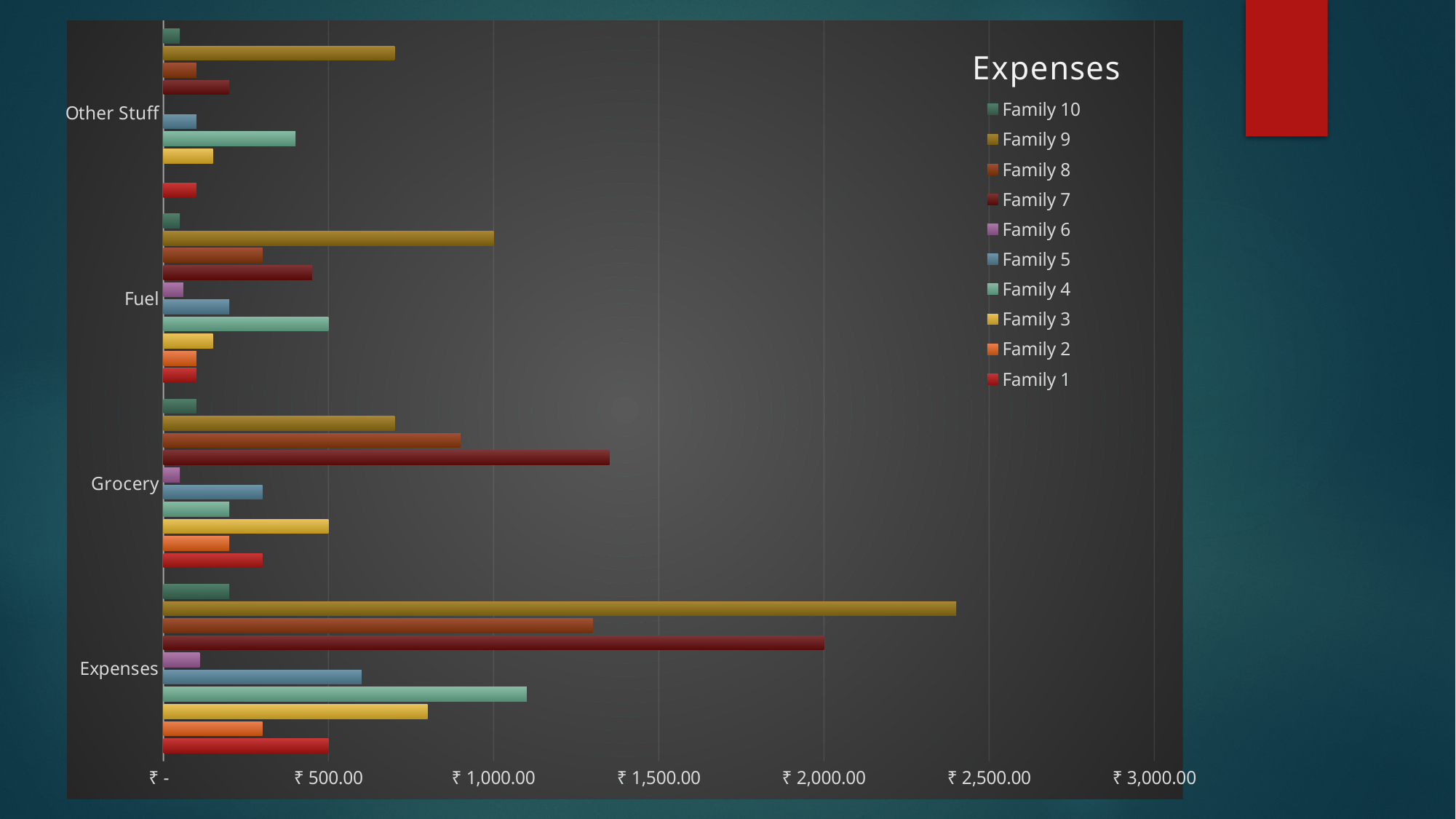
Which family has the highest value in the Expenses category? Family 9 What kind of chart is shown on the slide? bar chart Which family has the highest value in the Fuel category? Family 9 In the Expenses category, which is larger: the value for Family 7 or the value for Family 8? Family 7 What is the title of the chart? Expenses How many categories are shown on the vertical axis? 4 Is the value for Family 5 in the Expenses category greater or less than ₹ 1,000.00? less Is the value for Family 9 in the Expenses category greater or less than ₹ 2,000.00? greater Which family has the highest value in the Grocery category? Family 7 Is the value for Family 7 in the Grocery category greater or less than ₹ 1,000.00? greater In the Grocery category, which is larger: the value for Family 9 or the value for Family 7? Family 7 How many series does the legend list? 10